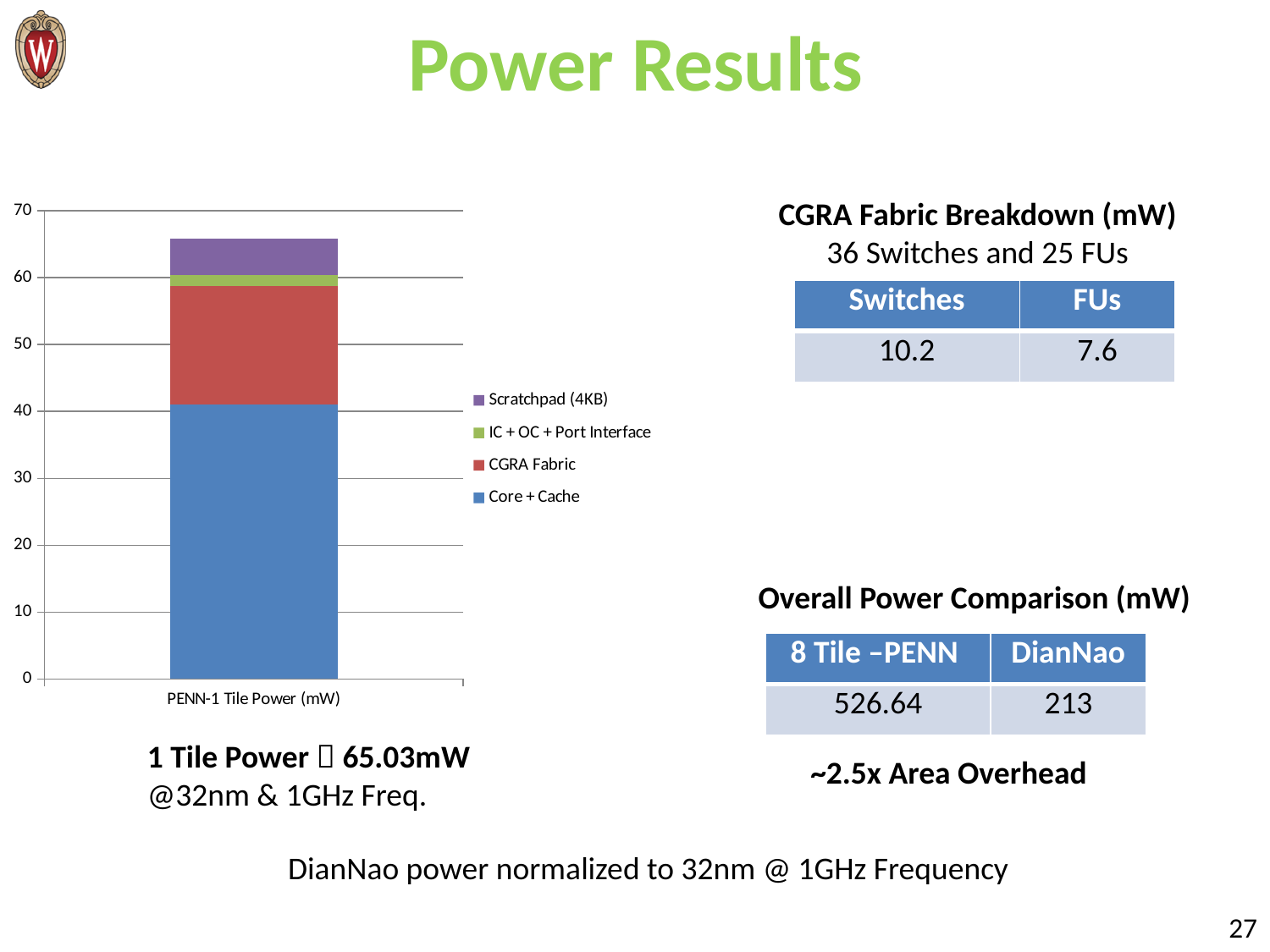
How many categories are plotted on the x axis of the chart? 1 Is the total height of the stacked bar greater or less than 60? greater Is the Scratchpad (4KB) segment larger or smaller than the IC + OC + Port Interface segment? Larger Is the value for Core + Cache greater or less than 40? greater How many series does the chart legend list? 4 Is the value for CGRA Fabric greater or less than 20? less What colour is the Core + Cache segment in the chart? Blue What kind of chart is shown on the slide? Stacked bar chart Which series contributes the largest segment to the stacked bar? Core + Cache What is the label of the single category on the chart's x axis? PENN-1 Tile Power (mW) Is the Core + Cache segment larger or smaller than the CGRA Fabric segment? Larger Which series contributes the smallest segment to the stacked bar? IC + OC + Port Interface